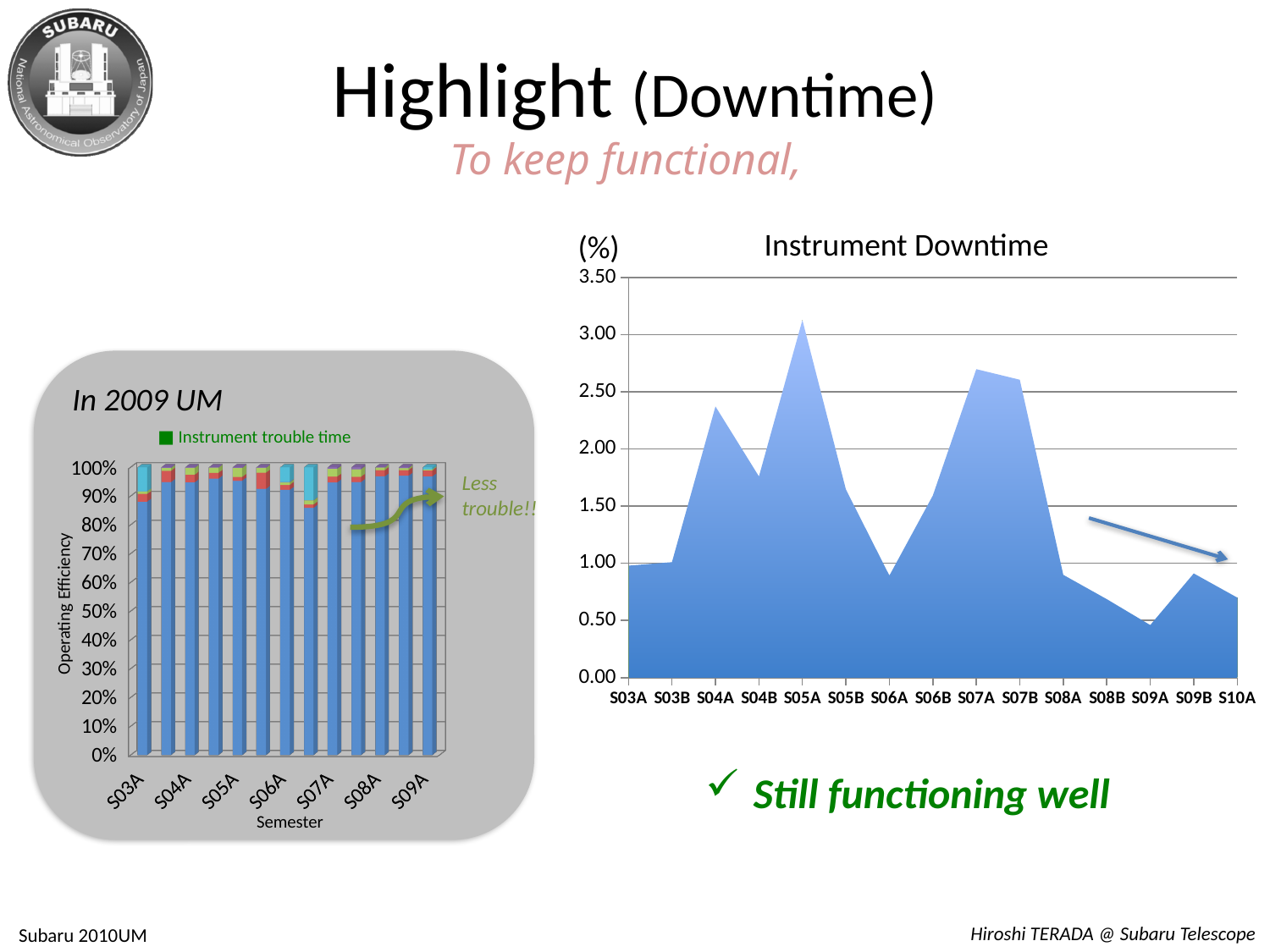
In the 'Instrument Downtime' chart, which is larger, the value for S04A or the value for S06A? S04A In the 'Instrument Downtime' chart, do the values rise or fall from S07A to S09A? fall In the 'Instrument Downtime' chart, is the value for S07A greater or less than 2.50? greater How many semesters are plotted along the x axis of the 'Instrument Downtime' chart? 15 What is the y-axis title of the 'In 2009 UM' chart on the left? Operating Efficiency What type of chart is the 'In 2009 UM' chart on the left? bar chart In the 'Instrument Downtime' chart, which semester has the highest downtime? S05A What type of chart is the 'Instrument Downtime' chart on the right? area chart In the 'Instrument Downtime' chart, which semester has the lowest downtime? S09A In the 'Instrument Downtime' chart, is the value for S06A greater or less than 1.00? less In the 'Instrument Downtime' chart, is the value for S05A greater or less than 3.00? greater